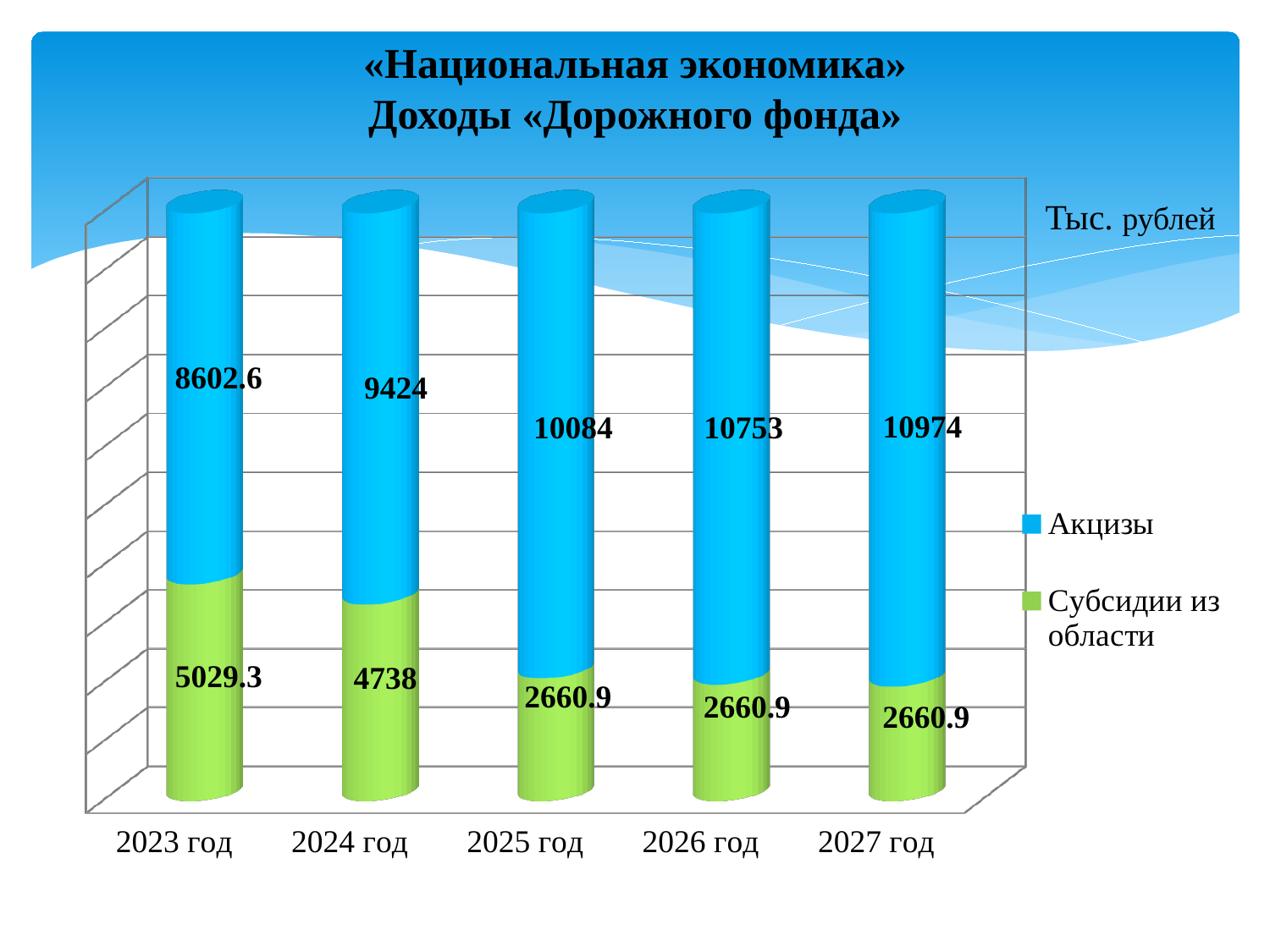
Do the Акцизы values rise or fall from 2023 год to 2027 год? Rise What is the value of Акцизы for 2025 год? 10084 What is the difference between the Акцизы values for 2024 год and 2023 год? 821.4 Which is larger: Субсидии из области for 2023 год or for 2024 год? 2023 год What is the value of Субсидии из области for 2023 год? 5029.3 How many years are shown on the x axis? 5 How many series does the legend list? 2 What kind of chart is shown on the slide? Stacked bar chart Which year has the highest value for Акцизы? 2027 год Which year has the lowest value for Акцизы? 2023 год What is the value of Акцизы for 2027 год? 10974 What is the total of the two series for 2024 год? 14162